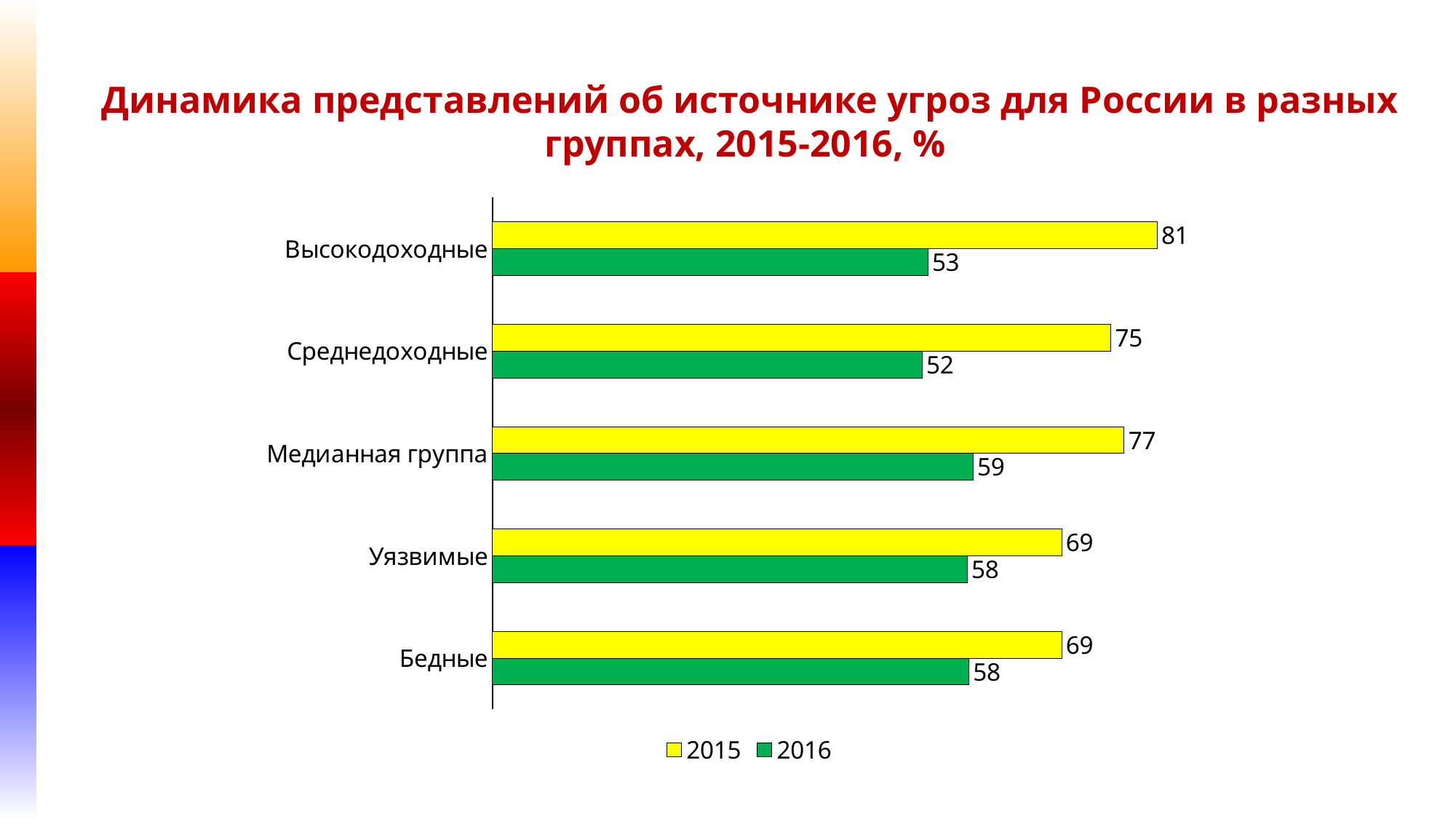
What is the difference between the 2015 and 2016 values for Высокодоходные? 28 Which colour represents the 2016 series? green Which group has the lowest 2016 value? Среднедоходные What is the 2016 value for Среднедоходные? 52 Which is larger: the 2016 value for Медианная группа or the 2016 value for Бедные? Медианная группа How many series does the legend list? 2 How many groups are shown on the chart? 5 What is the difference between the 2015 values for Среднедоходные and Уязвимые? 6 What is the 2015 value for Высокодоходные? 81 Which group has the highest 2015 value? Высокодоходные What kind of chart is shown on the slide? bar chart What is the 2016 value for Медианная группа? 59